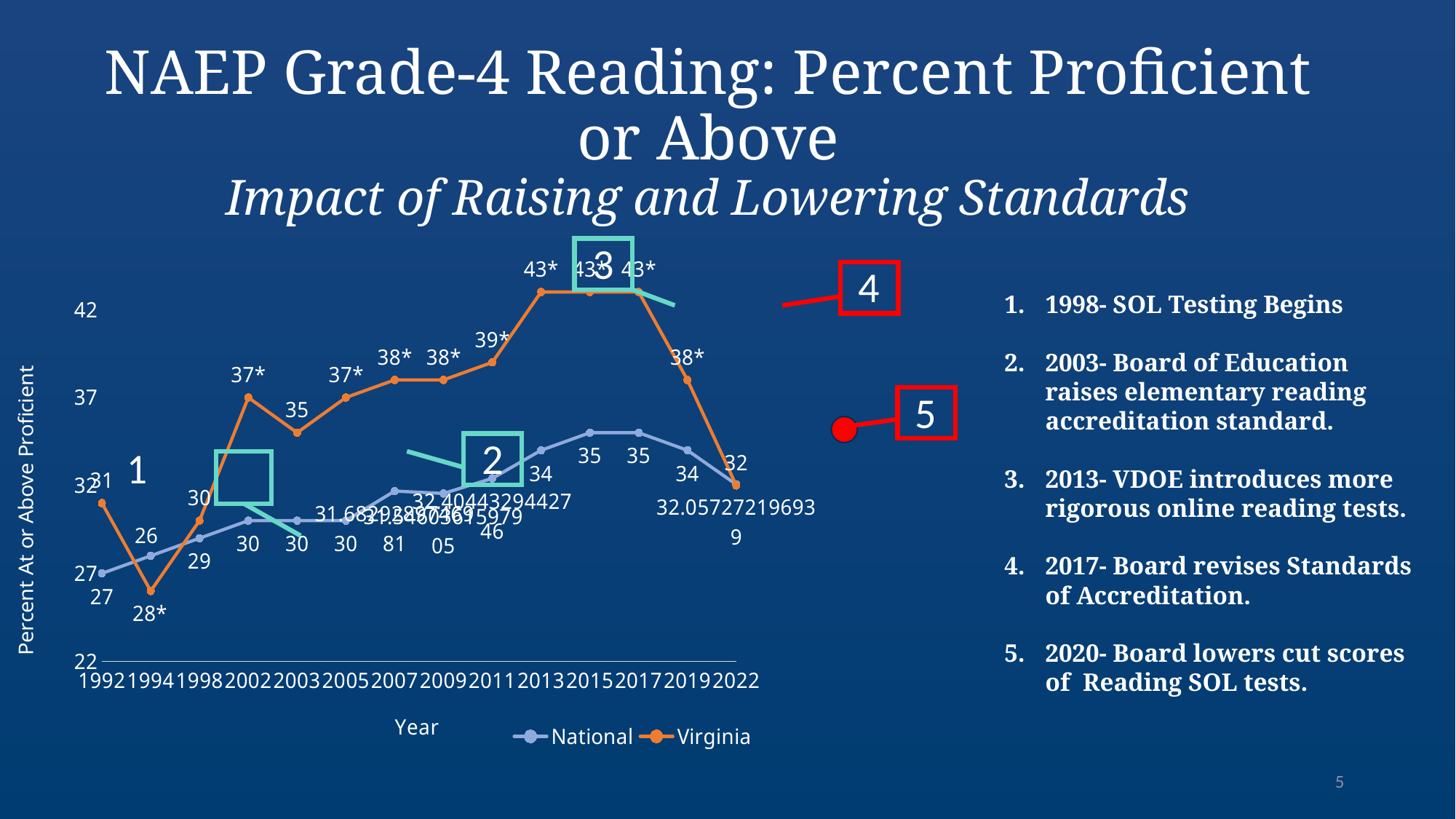
How many series does the chart legend list? 2 In which year is the Virginia value lowest? 1994 What are the two series named in the chart legend? National and Virginia Which series has the higher value in 2019, National or Virginia? Virginia Does the Virginia line rise or fall from 2017 to 2022? fall What kind of chart is shown on the slide? line chart What is the Virginia value for 2013? 43* How many years are plotted along the x axis? 14 What is the Virginia value for 2003? 35